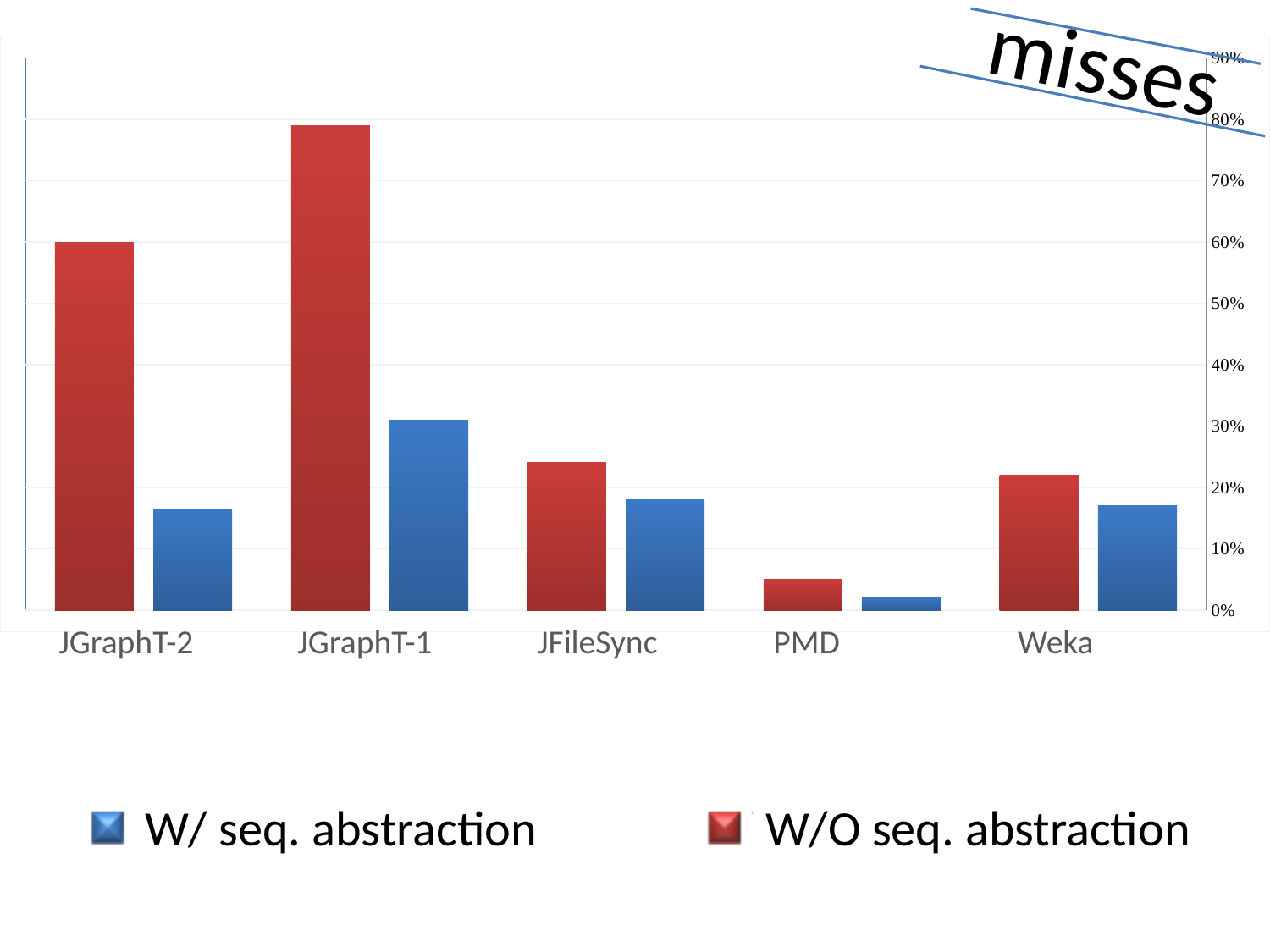
For the W/ seq. abstraction series, which is larger: JGraphT-1 or JFileSync? JGraphT-1 Is the W/ seq. abstraction value for JGraphT-2 greater or less than 20%? less What colour are the bars for the W/ seq. abstraction series? blue For JGraphT-2, which series has the larger value: W/ seq. abstraction or W/O seq. abstraction? W/O seq. abstraction How many series does the chart's legend list? 2 Is the W/O seq. abstraction value for JGraphT-1 greater or less than 70%? greater Which category has the lowest value for the W/O seq. abstraction series? PMD What kind of chart is shown on the slide? bar chart Which category has the highest value for the W/ seq. abstraction series? JGraphT-1 Which category has the highest value for the W/O seq. abstraction series? JGraphT-1 How many categories are shown on the x axis of the chart? 5 Which category has the lowest value for the W/ seq. abstraction series? PMD